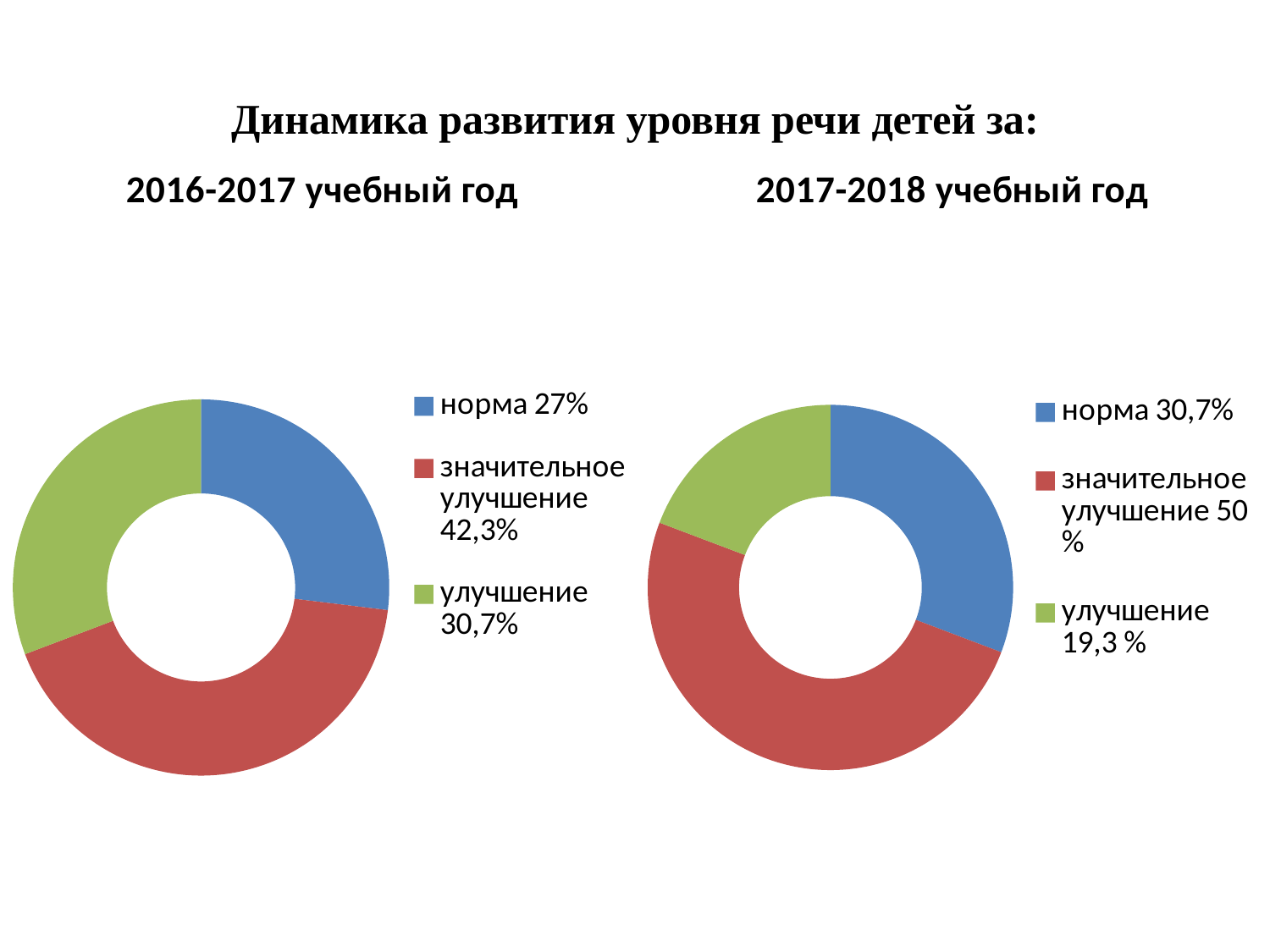
What type of chart is used for the 2017-2018 учебный год data? Doughnut (pie) chart In the 2016-2017 учебный год chart, what share is labelled for значительное улучшение? 42,3% In the 2016-2017 учебный год chart, what share is labelled for норма? 27% In the 2016-2017 учебный год chart, which category has the largest share? значительное улучшение What is the difference between the share for значительное улучшение in the 2017-2018 chart and in the 2016-2017 chart? 7,7% In the 2017-2018 учебный год chart, what share is labelled for норма? 30,7% In the 2017-2018 учебный год chart, what share is labelled for улучшение? 19,3 % In the 2017-2018 учебный год chart, which is larger: норма or значительное улучшение? значительное улучшение In the 2017-2018 учебный год chart, which category has the smallest share? улучшение What is the main title of the slide above the two charts? Динамика развития уровня речи детей за: In the 2016-2017 учебный год chart, what colour represents улучшение? Green How many categories does the 2016-2017 учебный год chart show? 3